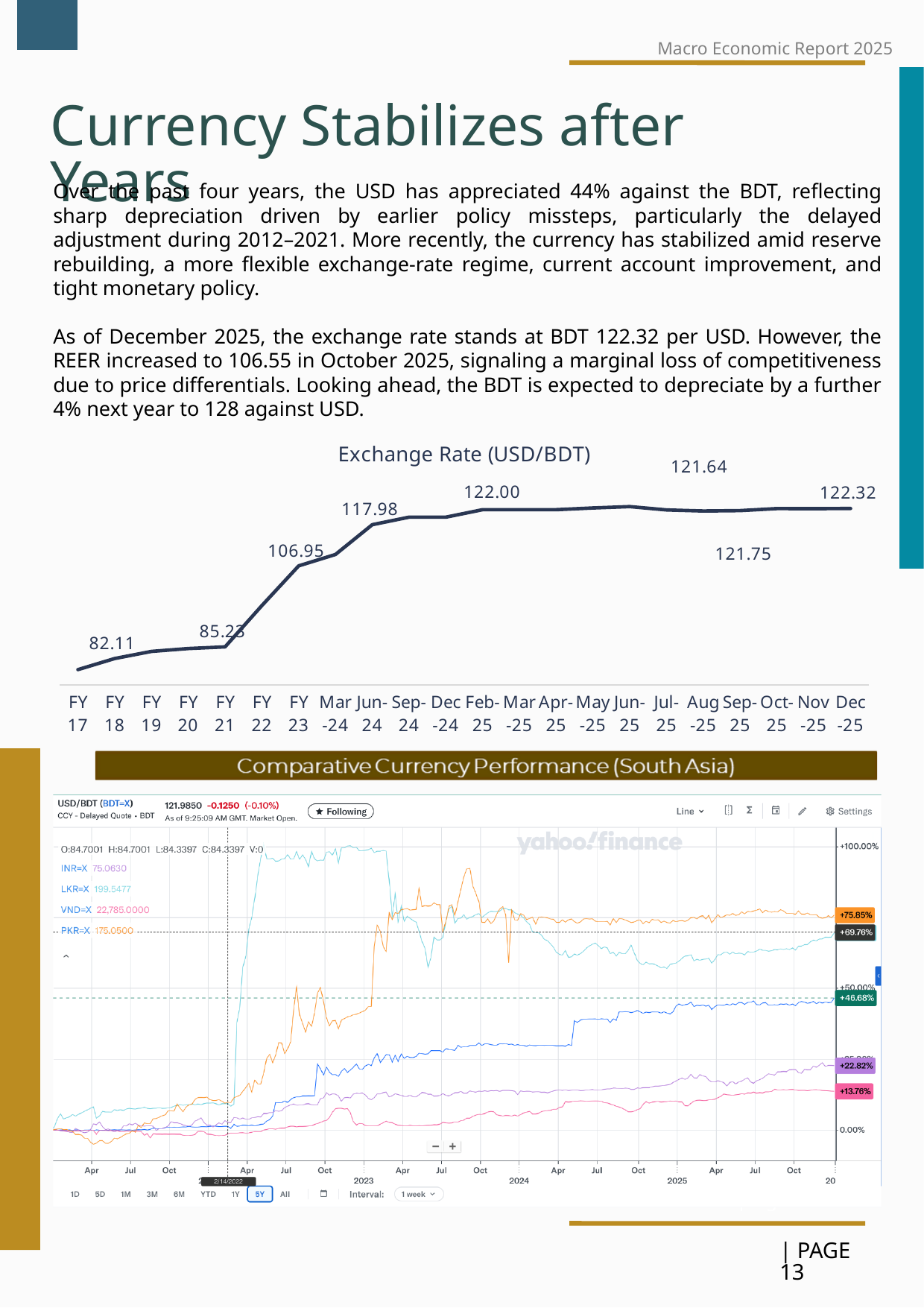
In the Comparative Currency Performance (South Asia) chart, what is the lowest percentage change labelled at the right edge? +13.76% In the Exchange Rate (USD/BDT) chart, does the exchange rate generally rise or fall from FY17 to Dec-25? Rise In the Exchange Rate (USD/BDT) chart, what is the value labelled at the final point, Dec-25? 122.32 In the Comparative Currency Performance (South Asia) chart, what USD/BDT quote is shown at the top left? 121.9850 In the Comparative Currency Performance (South Asia) chart, what is the highest percentage change labelled at the right edge? +75.85% In the Exchange Rate (USD/BDT) chart, what is the lowest value labelled on the line? 82.11 What kind of chart is the Exchange Rate (USD/BDT) chart? Line chart In the Exchange Rate (USD/BDT) chart, what is the difference between the highest labelled value (122.32) and the lowest labelled value (82.11)? 40.21 How many categories are shown on the x axis of the Exchange Rate (USD/BDT) chart? 22 In the Exchange Rate (USD/BDT) chart, what is the highest value labelled on the line? 122.32 In the Exchange Rate (USD/BDT) chart, which labelled value is larger, 117.98 or 106.95? 117.98 What is the title of the lower chart on the slide? Comparative Currency Performance (South Asia)